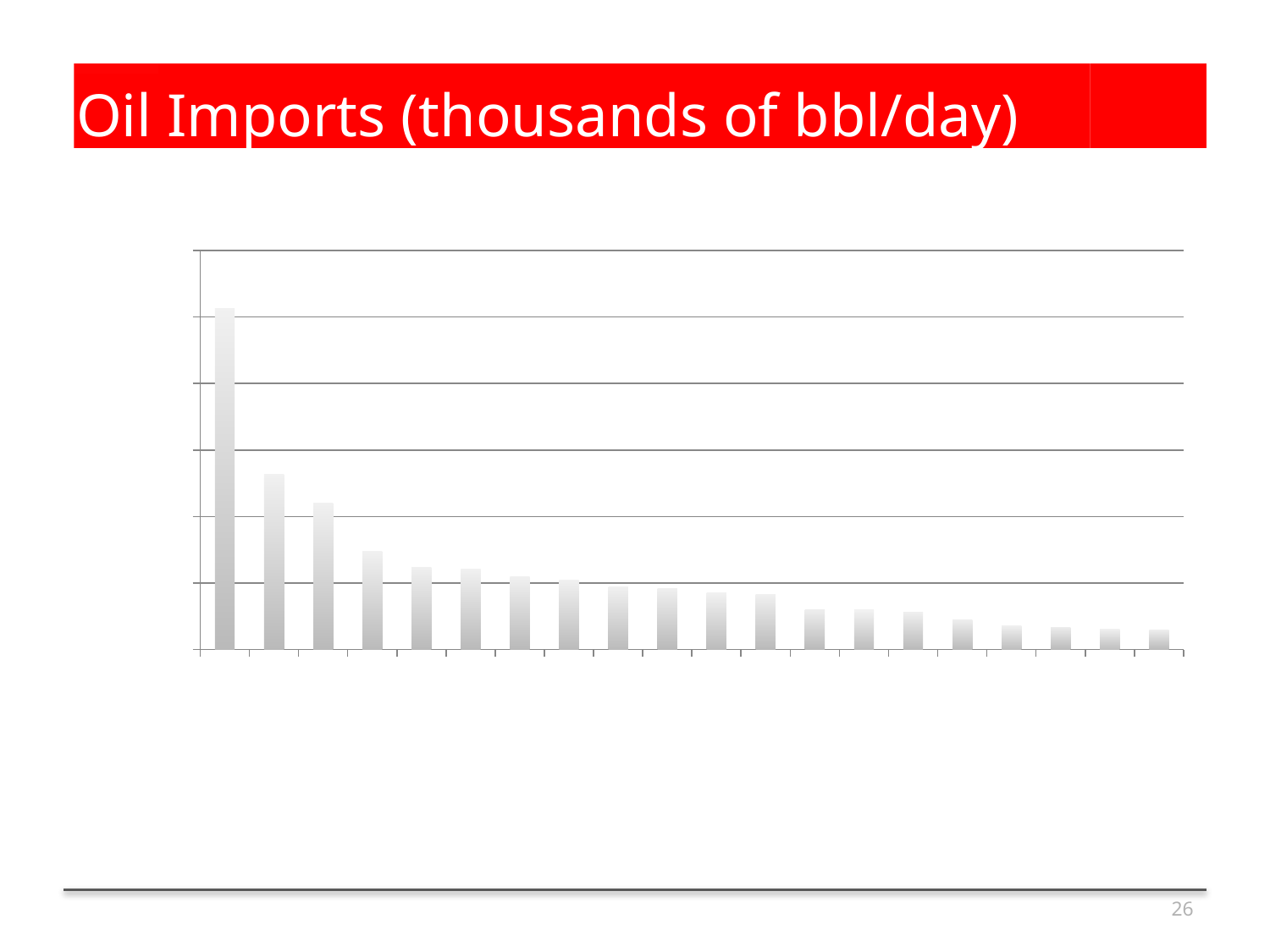
In what units are the oil imports expressed according to the slide title? thousands of bbl/day Which is larger, the first bar or the second bar? the first bar What kind of chart is shown on the slide? bar chart Which is larger, the third bar or the tenth bar? the third bar Which bar is the tallest in the chart? the first (leftmost) bar Which is larger, the fourth bar or the fifth bar? the fourth bar Do the bar values rise or fall from left to right along the x axis? fall What is the title of the slide containing the chart? Oil Imports (thousands of bbl/day) How many bars are plotted in the chart? 20 How many data series are plotted in the chart? 1